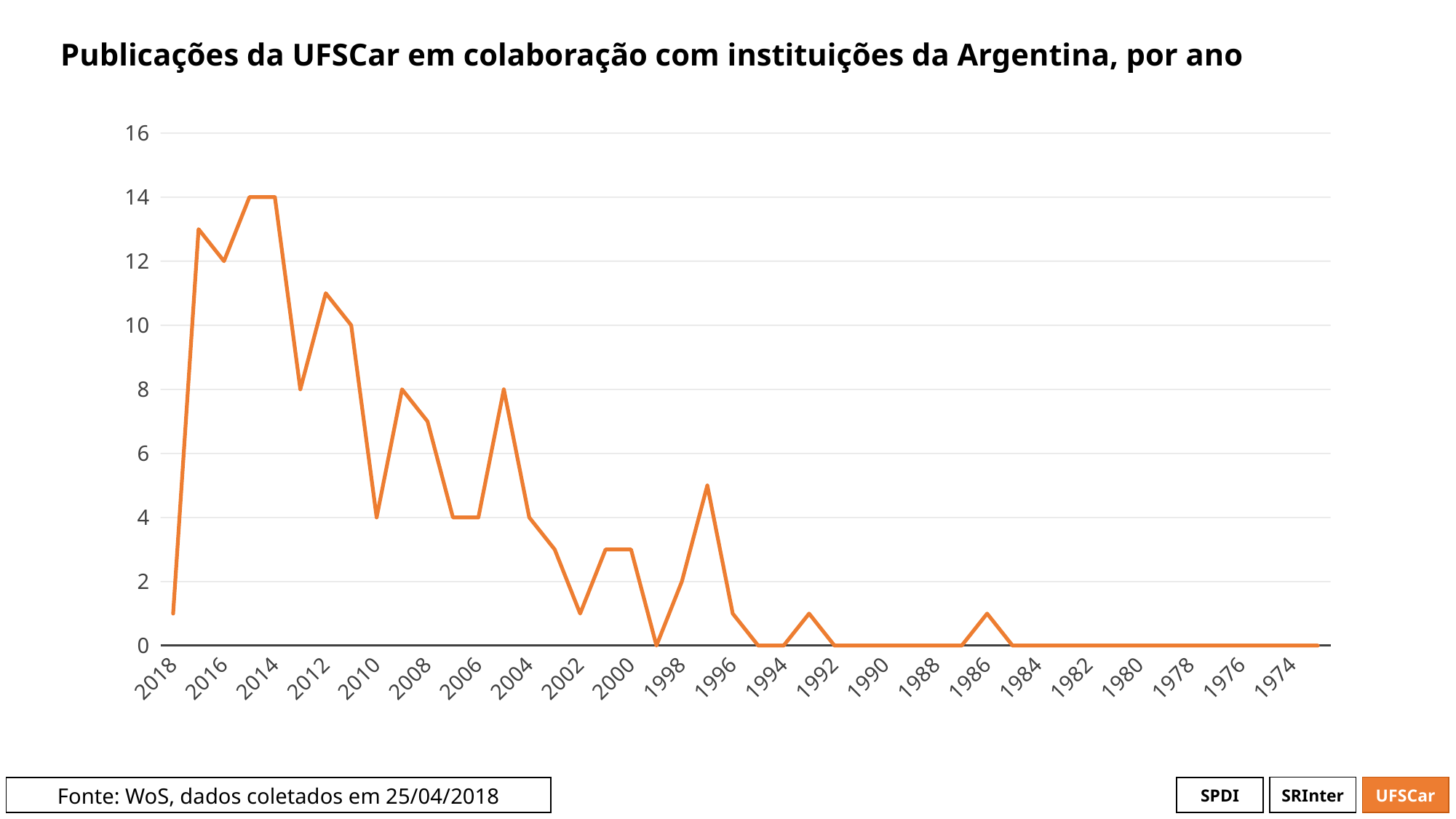
Is the value for 2012 greater or less than 10? greater What is the difference between the values for 2014 and 2010? 10 What kind of chart is shown on the slide? line chart What is the value for 1990? 0 What is the highest value reached by the line? 14 What is the value for 1998? 2 What is the title of the chart? Publicações da UFSCar em colaboração com instituições da Argentina, por ano What is the value for 2016? 12 Which year has the larger value, 2016 or 2010? 2016 Is the value for 2002 greater or less than 2? less What is the value for 2014? 14 What is the value for 2010? 4